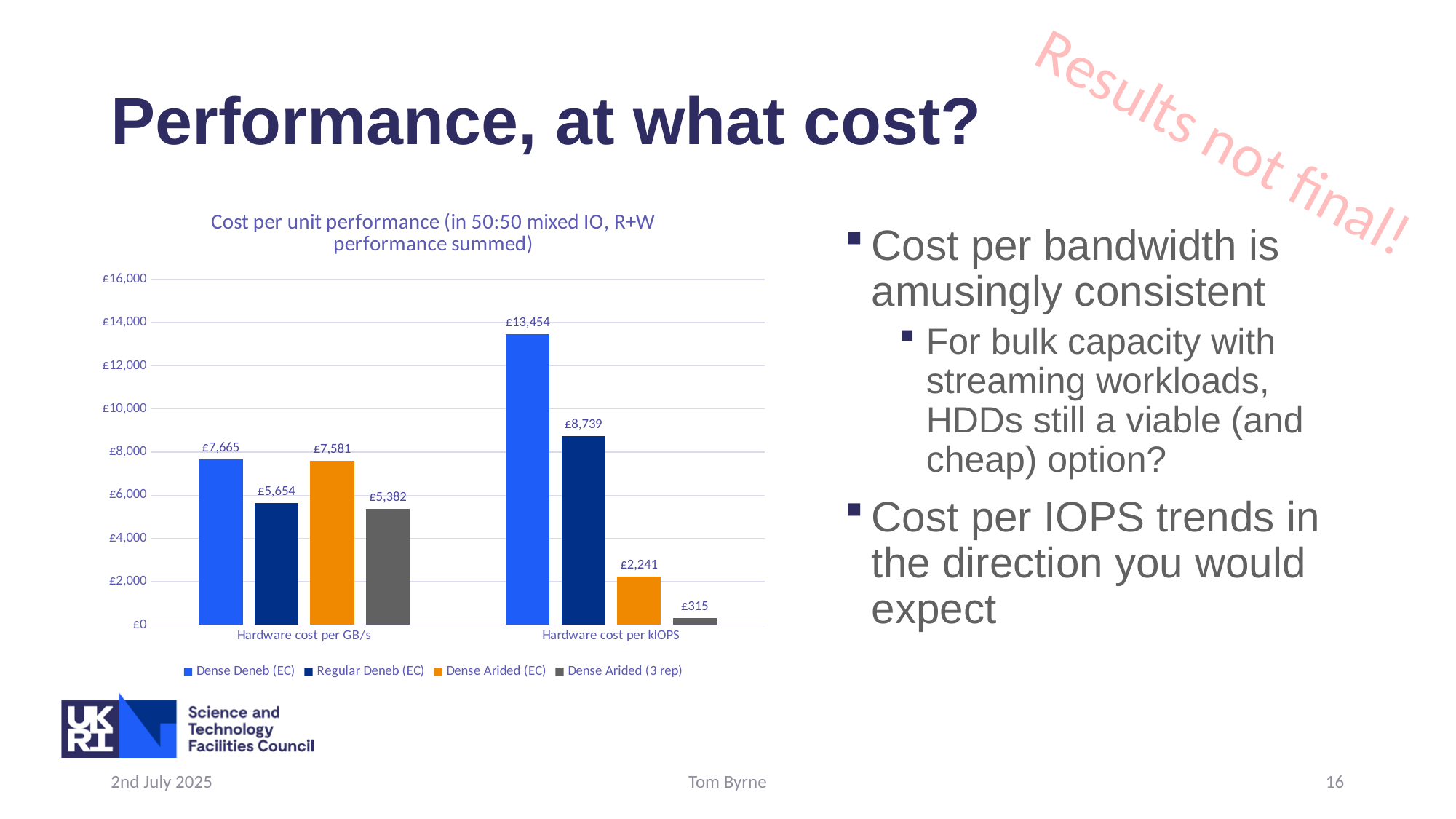
What is the difference between Dense Arided (EC) and Dense Arided (3 rep) in the Hardware cost per GB/s category? £2,199 What kind of chart is shown on the slide? Bar chart How many categories are shown on the x axis? 2 What is the value for Regular Deneb (EC) in the Hardware cost per kIOPS category? £8,739 What is the difference between Dense Deneb (EC) and Regular Deneb (EC) in the Hardware cost per kIOPS category? £4,715 Which series has the lowest value in the Hardware cost per GB/s category? Dense Arided (3 rep) Which is larger: Dense Arided (EC) for Hardware cost per GB/s or Regular Deneb (EC) for Hardware cost per GB/s? Dense Arided (EC) How many series does the legend list? 4 Which series has the highest value in the Hardware cost per kIOPS category? Dense Deneb (EC) What is the value for Dense Deneb (EC) in the Hardware cost per GB/s category? £7,665 Is the value for Dense Deneb (EC) in the Hardware cost per kIOPS category greater or less than £12,000? greater What is the value for Dense Arided (3 rep) in the Hardware cost per kIOPS category? £315